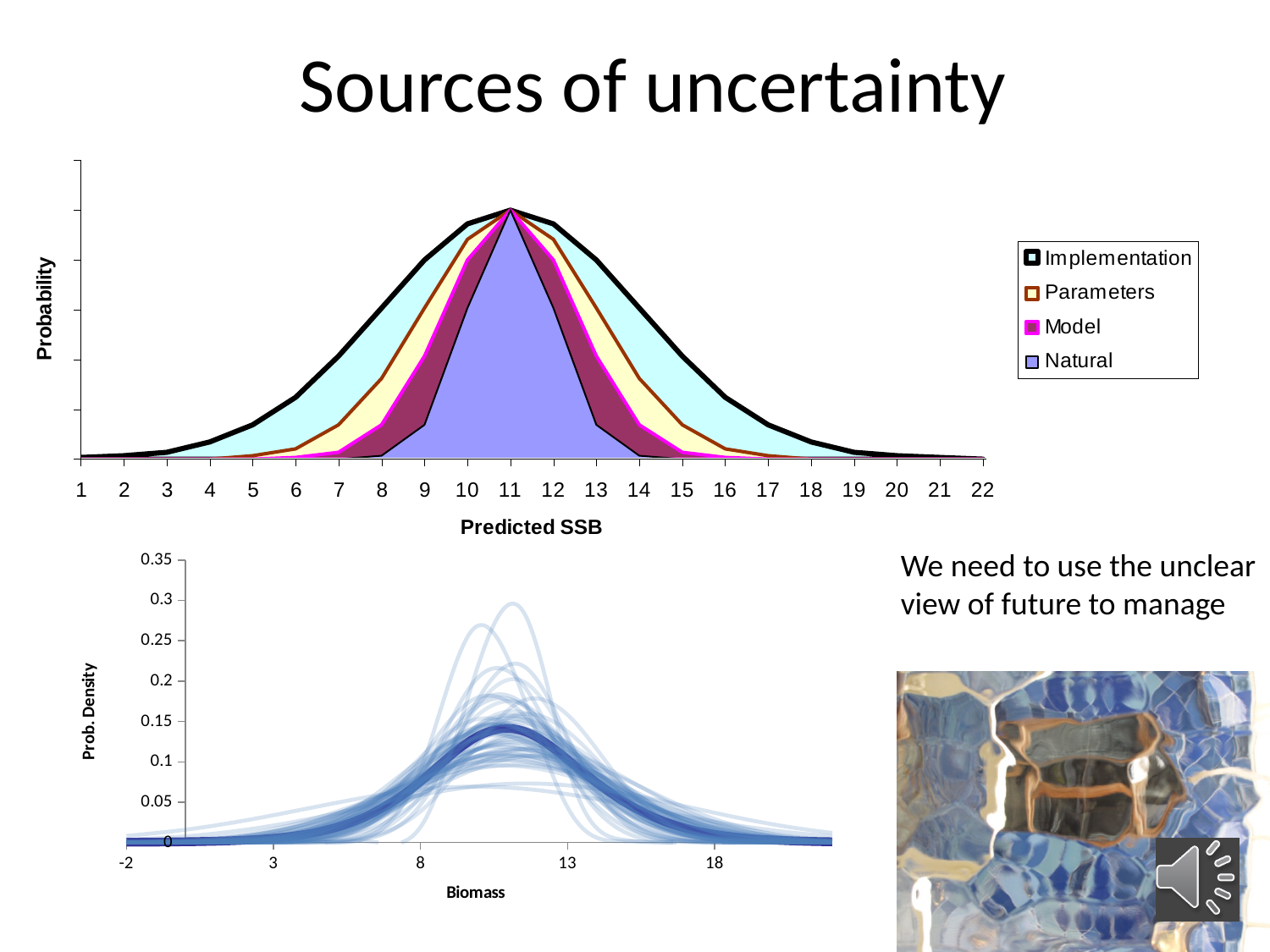
What is the title of the slide containing the charts? Sources of uncertainty What kind of chart is the bottom chart? Line chart In the top chart, which series covers the narrowest range of Predicted SSB values? Natural What kind of chart is the top chart? Area chart In the bottom chart, is the highest peak reached by any of the curves greater or less than 0.25? greater What is the x-axis title of the bottom chart? Biomass In the top chart, how many Predicted SSB values are labelled along the x axis? 22 In the top chart, how many series does the legend list? 4 In the top chart, at which Predicted SSB value do all the distributions reach their peak? 11 In the bottom chart, what is the maximum value shown on the Prob. Density axis? 0.35 In the top chart, which series covers the widest range of Predicted SSB values? Implementation